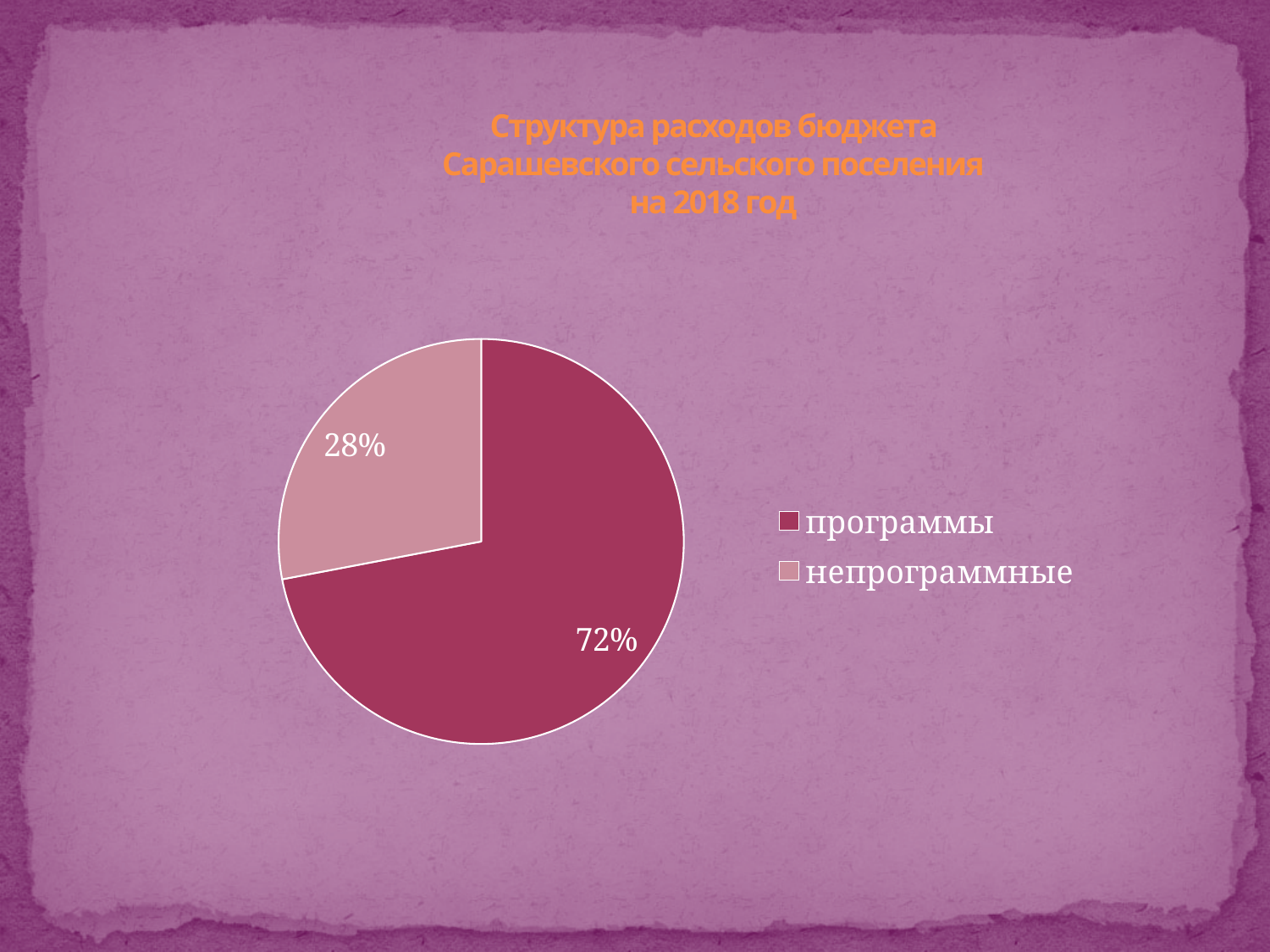
What is the title of the chart? Структура расходов бюджета Сарашевского сельского поселения на 2018 год Which is larger, the "программы" slice or the "непрограммные" slice? программы Which slice is the smallest in the pie chart? непрограммные How many entries does the legend list? 2 What share of the pie does the "непрограммные" slice represent? 28% Which legend entry is shown in the lighter pink colour? непрограммные How many slices does the pie chart have? 2 What is the difference in percentage points between the "программы" and "непрограммные" slices? 44 What kind of chart is shown on the slide? pie chart What share of the pie does the "программы" slice represent? 72% Which slice is the largest in the pie chart? программы